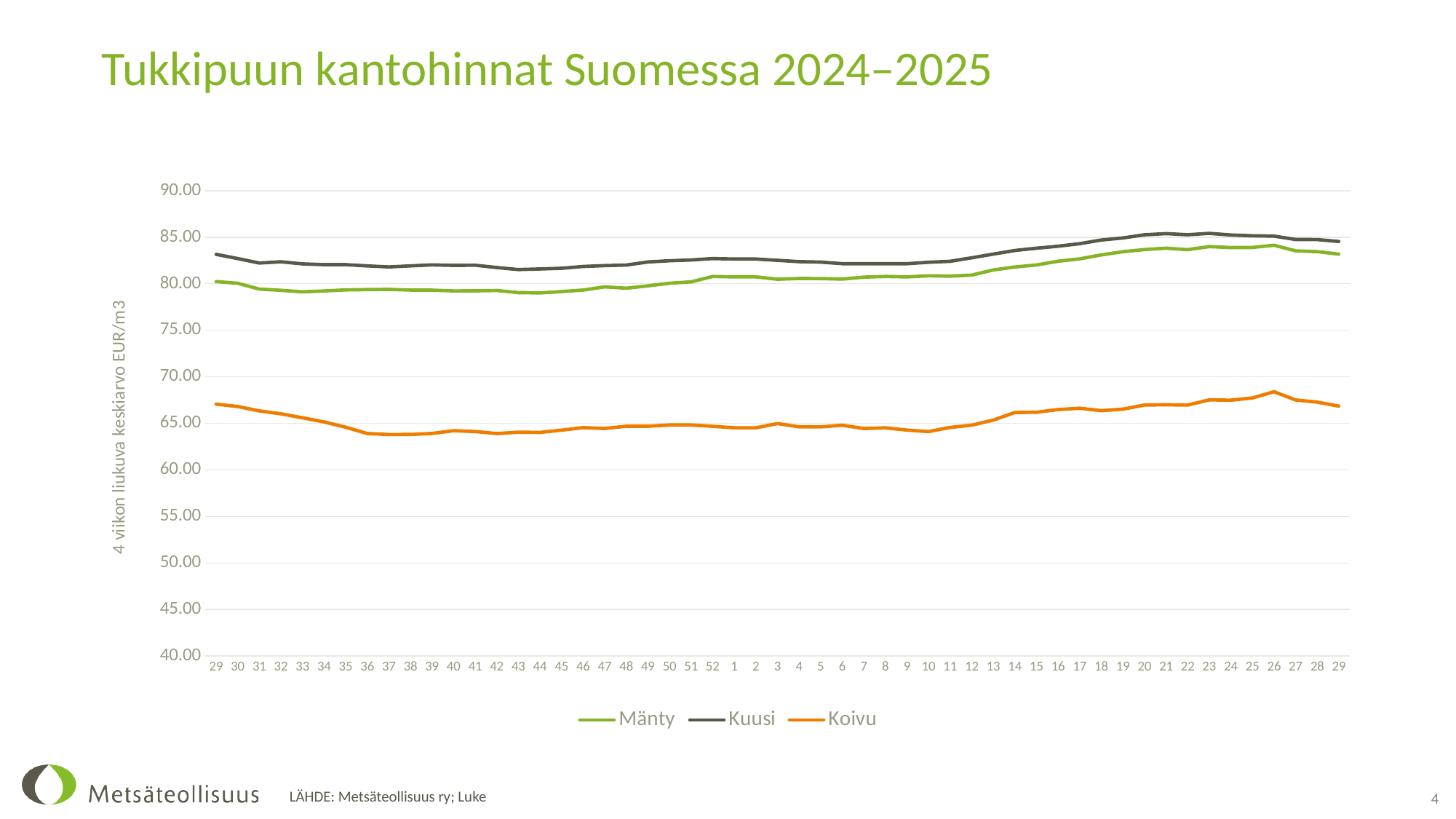
Does the Koivu line rise or fall from week 29 to week 36? fall Is the value for Kuusi at week 43 greater or less than 80.00? greater How many series does the legend list? 3 What is the title of the chart on the slide? Tukkipuun kantohinnat Suomessa 2024–2025 Is the value for Koivu at week 36 greater or less than 65.00? less At week 29 at the start of the chart, which is larger: Kuusi or Mänty? Kuusi Is the value for Koivu at week 26 greater or less than 65.00? greater Which series is plotted with the highest values throughout the chart? Kuusi What kind of chart is shown on the slide? line chart Does the Mänty line rise or fall from week 12 to week 26? rise Which series is plotted with the lowest values throughout the chart? Koivu